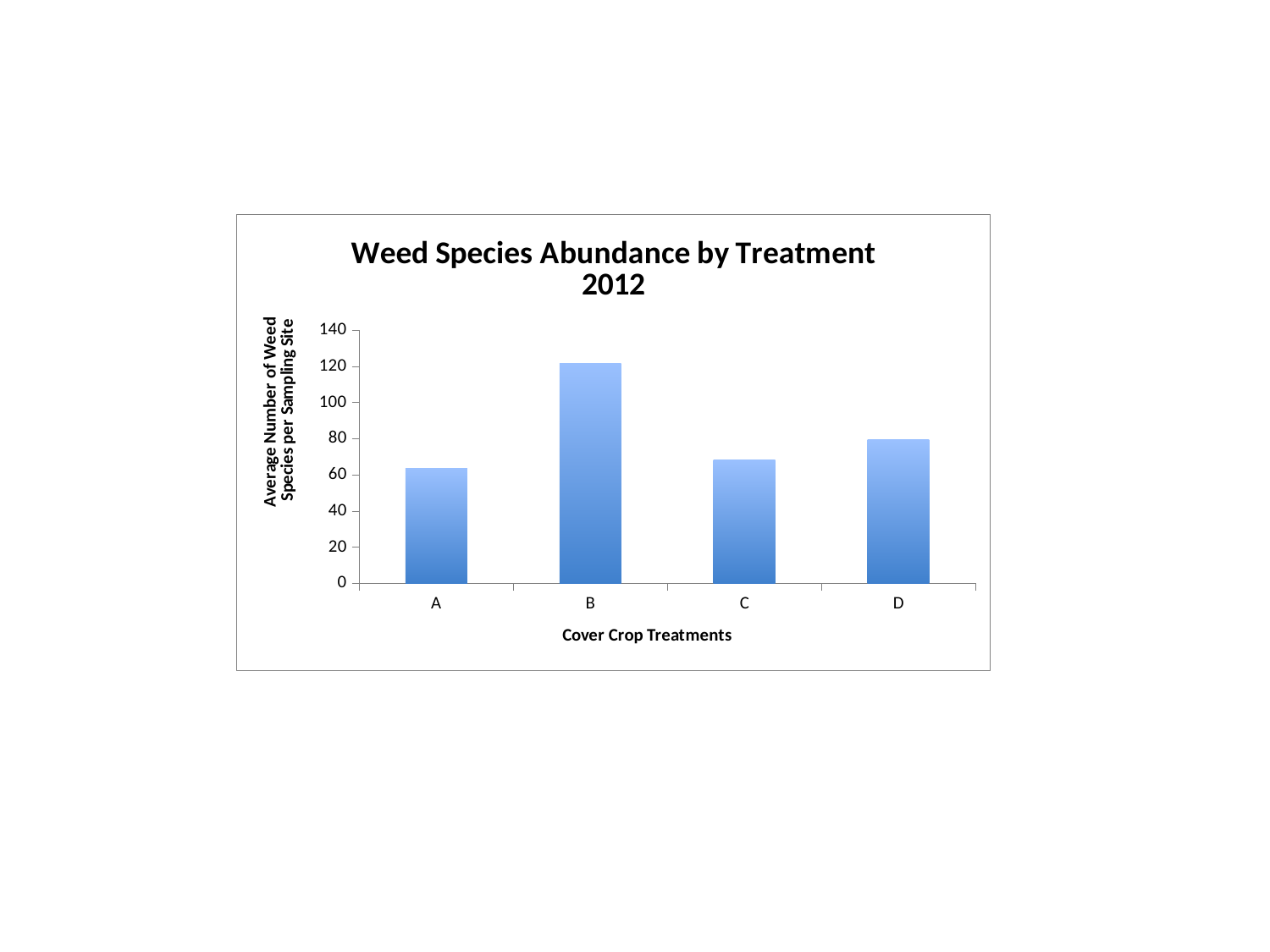
Which has a larger value, treatment B or treatment D? B How many cover crop treatments are shown on the x axis? 4 What kind of chart is shown on the slide? bar chart Which treatment has the lowest average number of weed species per sampling site? A What is the title of the chart? Weed Species Abundance by Treatment 2012 Is the value for treatment C greater or less than 80? less Which has a larger value, treatment C or treatment D? D Is the value for treatment A greater or less than 80? less Which treatment has the highest average number of weed species per sampling site? B Is the value for treatment D greater or less than 60? greater